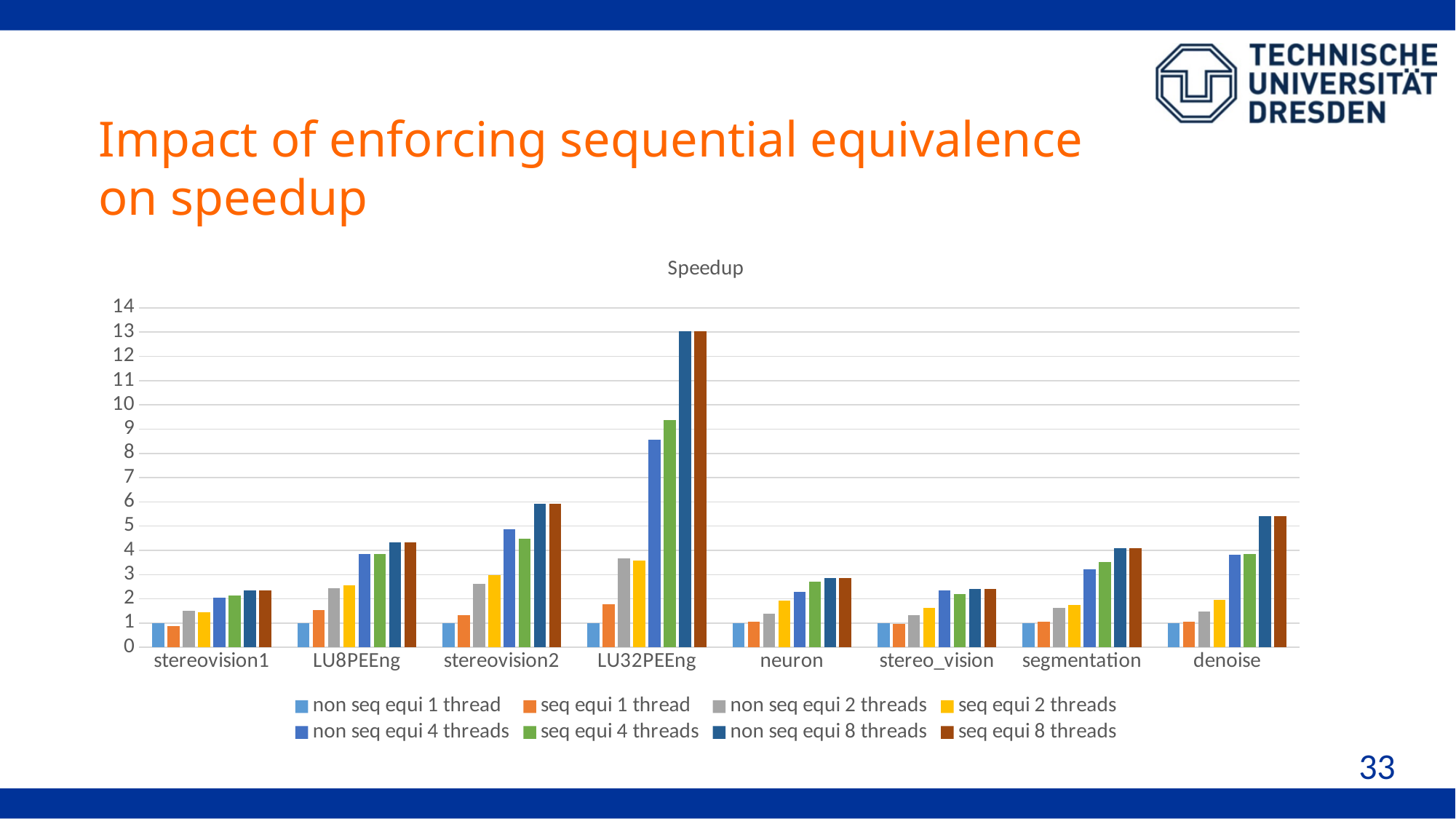
What is the value for non seq equi 1 thread on stereovision1? 1 How many benchmark categories are shown on the x axis? 8 Which is larger for stereovision2: non seq equi 4 threads or seq equi 4 threads? non seq equi 4 threads What kind of chart is shown on the slide? bar chart How many series does the legend list? 8 Which is larger for LU32PEEng: non seq equi 4 threads or seq equi 4 threads? seq equi 4 threads Is the value for non seq equi 4 threads on LU32PEEng greater or less than 8? greater What is the title of the chart? Speedup Is the value for non seq equi 8 threads on denoise greater or less than 5? greater Is the value for non seq equi 8 threads on LU32PEEng greater or less than 12? greater Which benchmark has the highest speedup for non seq equi 8 threads? LU32PEEng